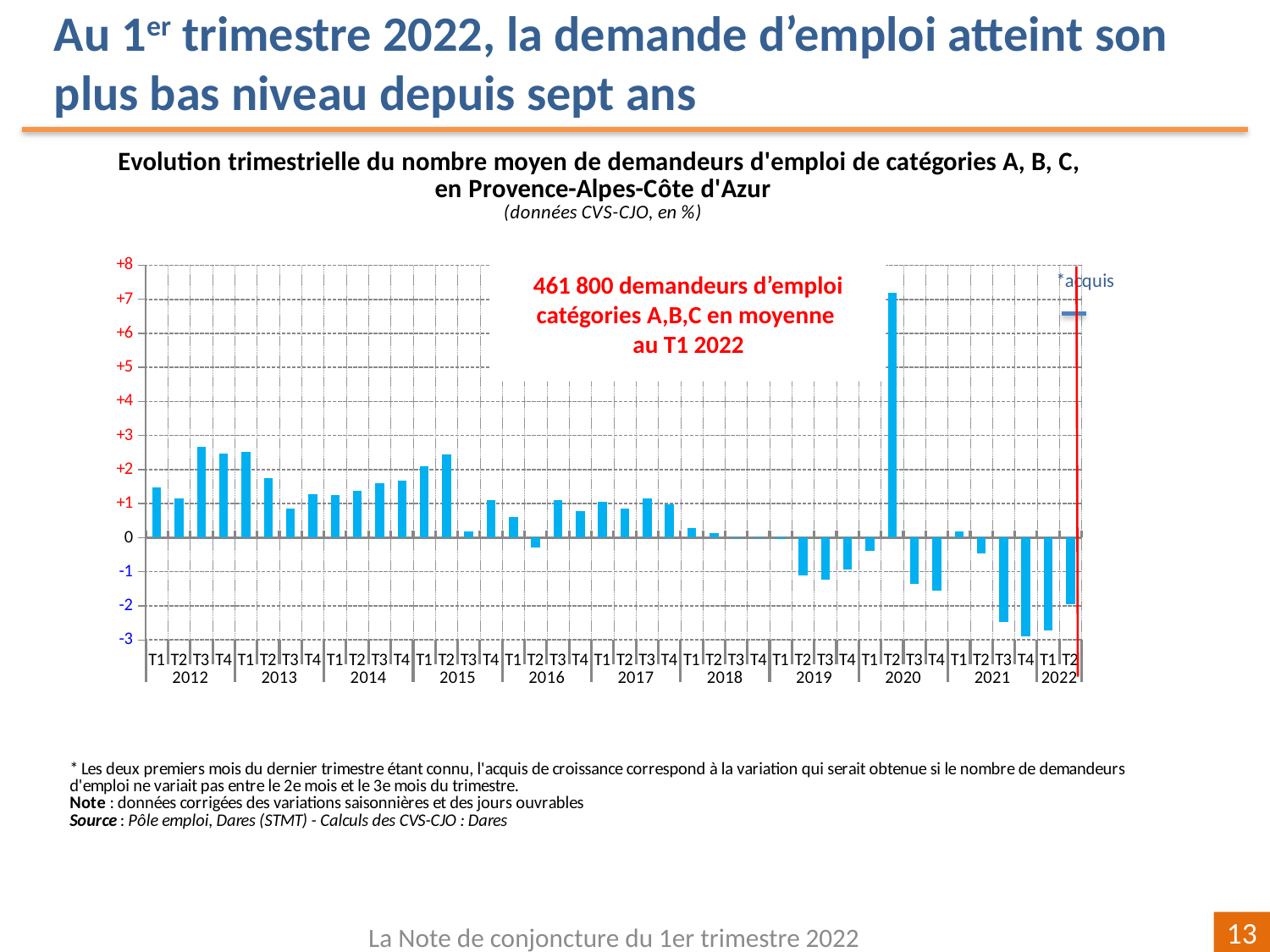
Which is larger, the value for T1 2013 or the value for T3 2013? T1 2013 What kind of chart is shown on the slide? bar chart Which quarter has the highest value in the chart? T2 2020 Is the value for T3 2012 greater or less than +2? greater Is the value for T1 2012 greater or less than +1? greater Is the value for T4 2020 greater or less than -1? less How many years are labelled on the x axis of the chart? 11 Do the values rise or fall across the four quarters of 2021 (T1 to T4)? fall According to the annotation on the chart, how many job seekers in categories A, B, C were there on average in T1 2022? 461 800 Which is larger, the value for T2 2020 or the value for T3 2012? T2 2020